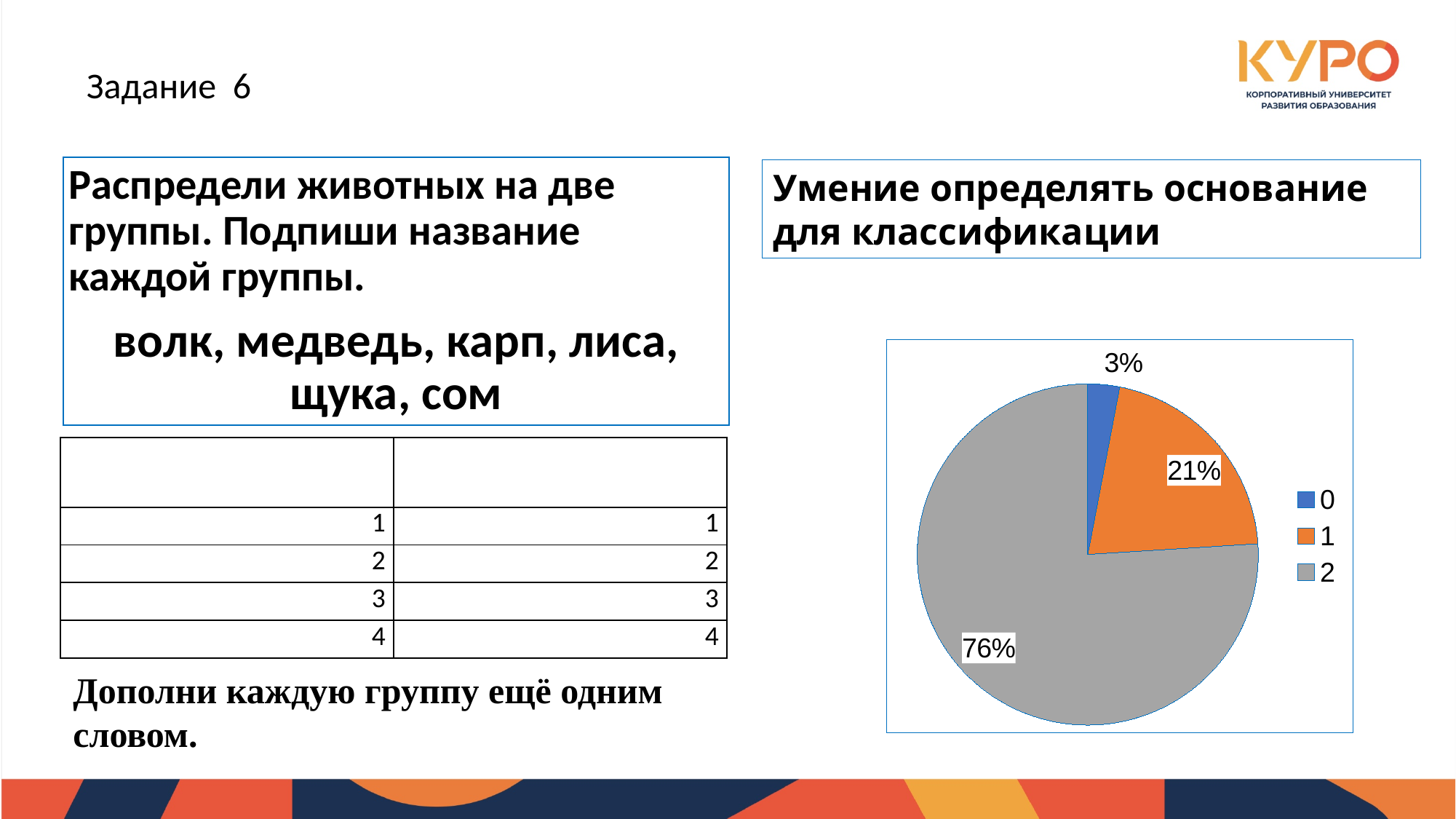
What share of the pie does category 0 have? 3% What is the difference in percentage points between the slices for category 2 and category 1? 55 What share of the pie does category 2 have? 76% How many slices does the pie chart have? 3 Which category has the smallest slice of the pie? 0 Which category has the largest slice of the pie? 2 Which slice is larger, category 1 or category 0? 1 What colour is the slice for category 1 in the pie chart? orange What colour is the slice for category 2 in the pie chart? grey What kind of chart is shown on the slide? pie chart How many entries does the legend of the pie chart list? 3 What share of the pie does category 1 have? 21%